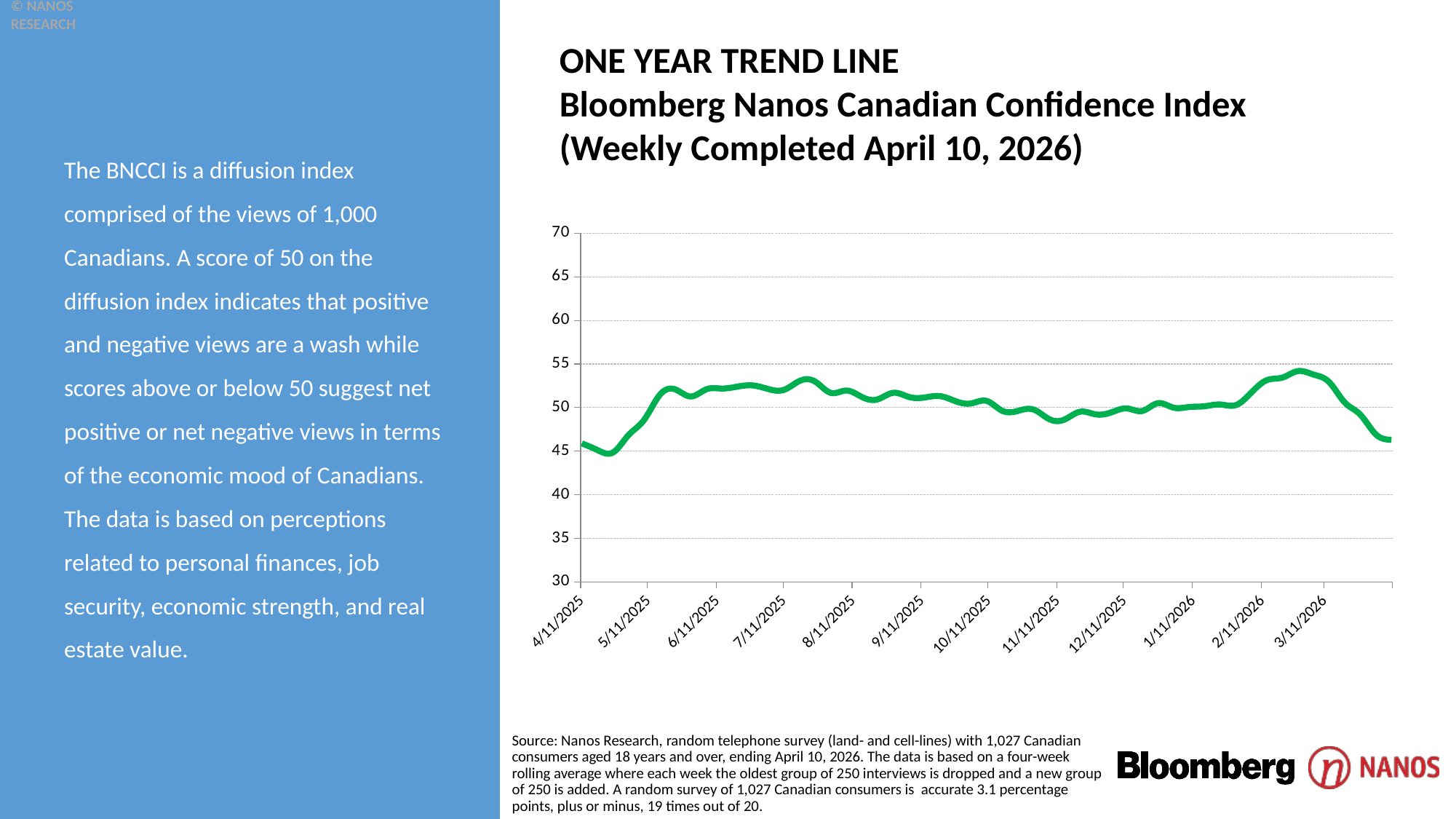
Is the value of the index at 11/11/2025 greater or less than 50? less Does the index rise or fall between 4/11/2025 and 5/11/2025? rise Near which labelled date does the line reach its highest value? 3/11/2026 Is the value of the index at 7/11/2025 greater or less than 50? greater Is the highest point of the line greater or less than 55? less What colour is the line plotted on the chart? green What kind of chart is shown on the slide? line chart What is the title of the chart on the slide? ONE YEAR TREND LINE Bloomberg Nanos Canadian Confidence Index (Weekly Completed April 10, 2026) How many date labels are shown along the x axis of the chart? 12 Does the index rise or fall from 3/11/2026 to the end of the period? fall